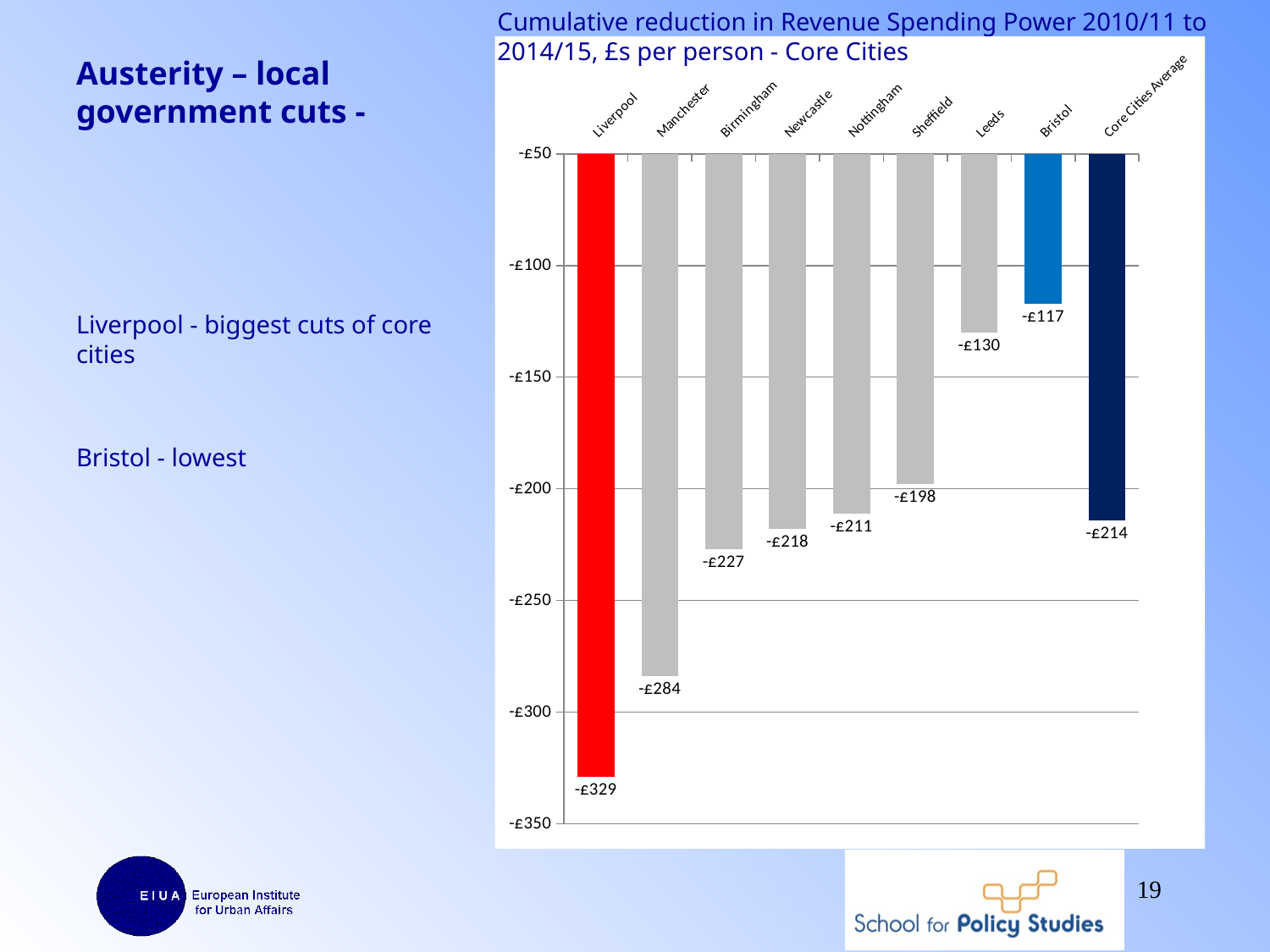
What is the value shown for Bristol? -£117 What kind of chart is shown on the slide? Bar chart What is the title of the chart? Cumulative reduction in Revenue Spending Power 2010/11 to 2014/15, £s per person - Core Cities Which has the larger reduction per person, Newcastle or Leeds? Newcastle Which city has the largest cumulative reduction in revenue spending power? Liverpool Which city has the smallest cumulative reduction in revenue spending power? Bristol How many bars are plotted on the chart? 9 What is the value shown for Liverpool? -£329 What is the value shown for Sheffield? -£198 What is the value shown for the Core Cities Average? -£214 How much larger is Liverpool's reduction than Bristol's, in £ per person? £212 How much larger is Manchester's reduction than Birmingham's, in £ per person? £57